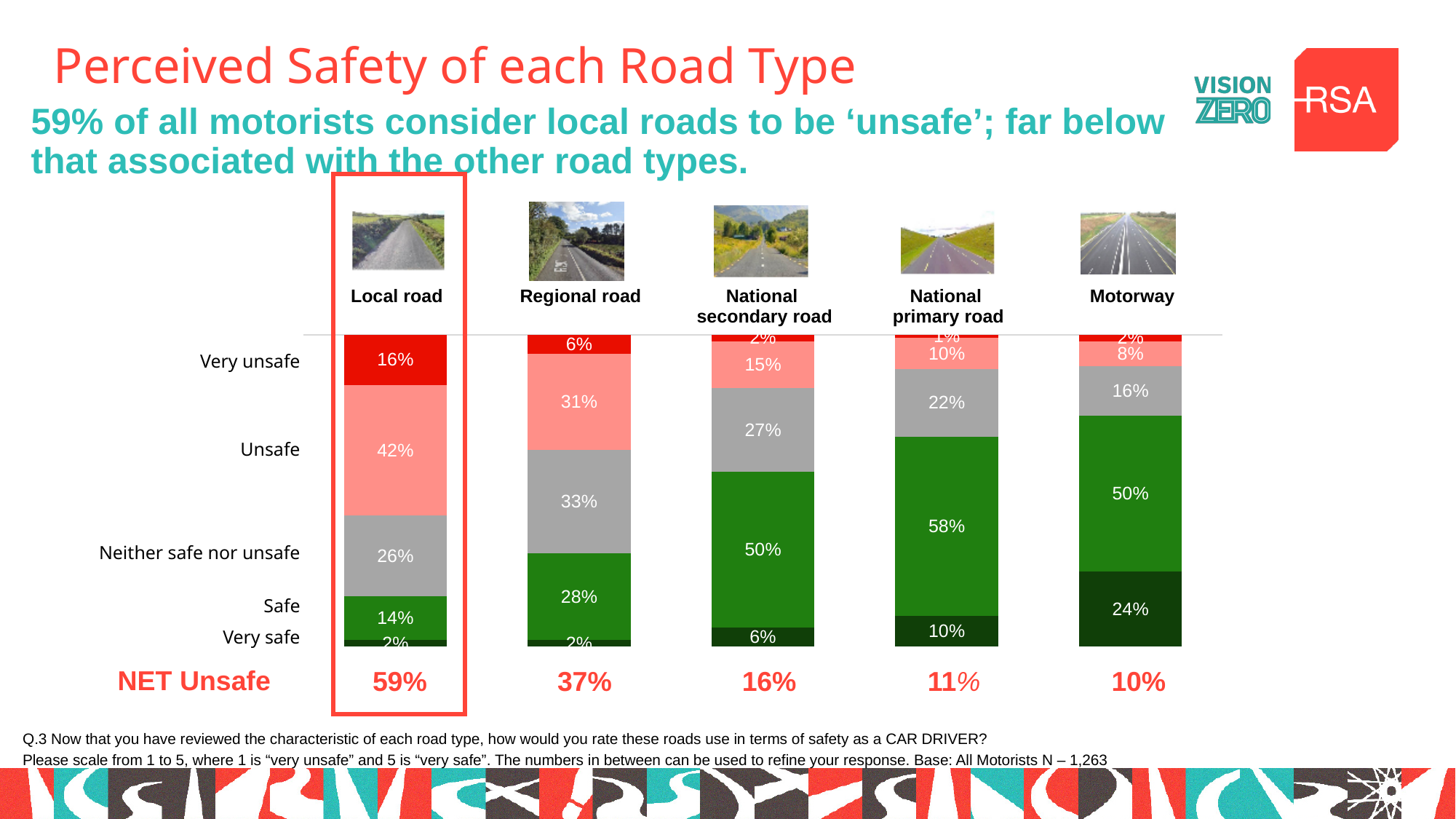
How many road types are shown in the chart? 5 What percentage of motorists rated the National primary road as 'Safe'? 58% Which has a higher 'Safe' percentage: the National secondary road or the Regional road? National secondary road How many percentage points higher is the NET Unsafe figure for the Local road than for the Regional road? 22 percentage points Which road type has the lowest NET Unsafe percentage? Motorway What kind of chart is used to show the perceived safety of each road type? Stacked bar chart What is the NET Unsafe figure for the National secondary road? 16% What percentage of motorists rated the Local road as 'Unsafe'? 42% What is the 'Neither safe nor unsafe' percentage for the Regional road? 33% What percentage of motorists rated the Motorway as 'Very safe'? 24% Which road type is highlighted with a red outline box on the slide? Local road Which road type has the highest NET Unsafe percentage? Local road